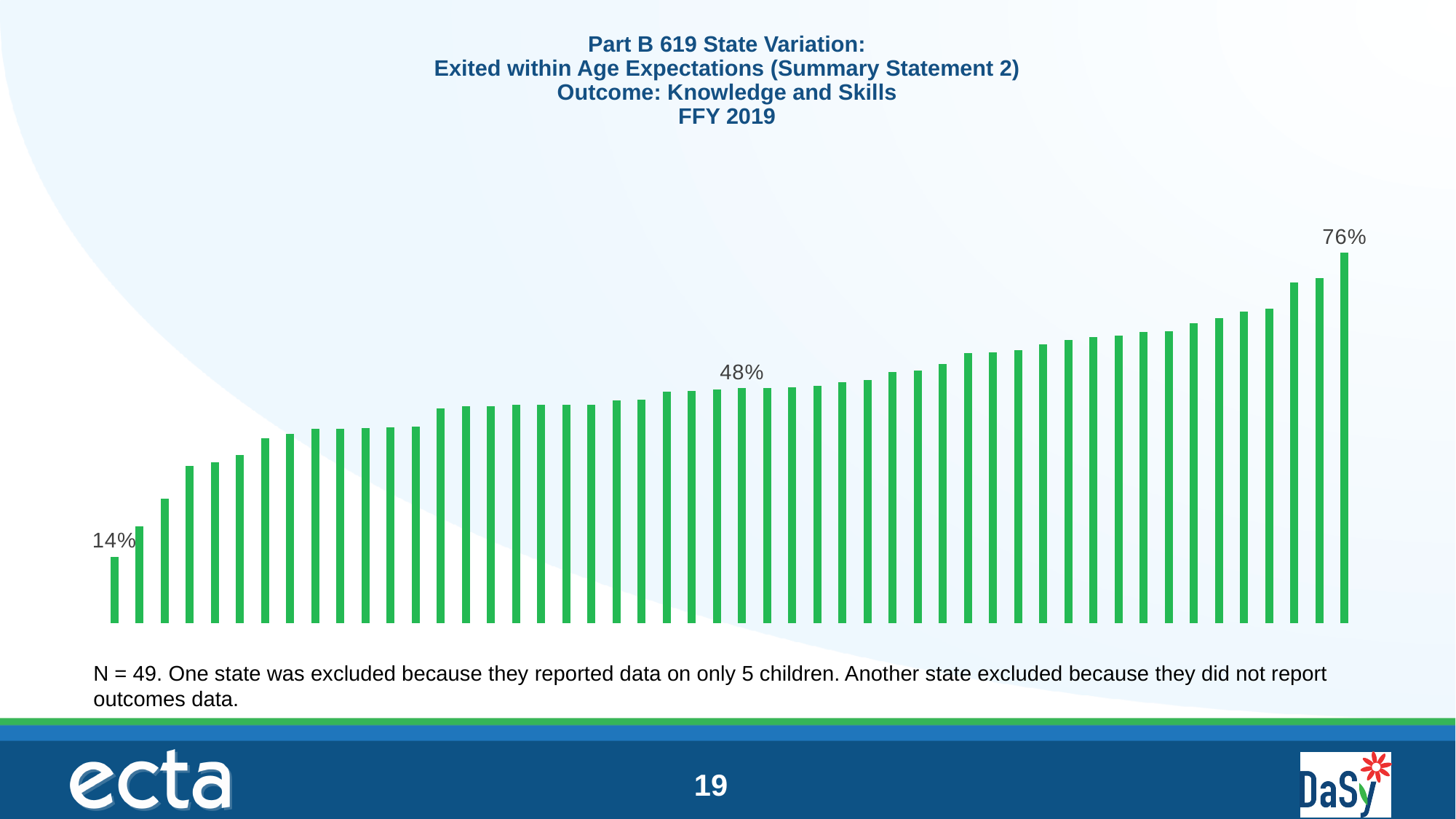
Is the bar labeled 48% larger or smaller than the bar labeled 76%? smaller What kind of chart is shown on the slide? bar chart What is the difference between the highest labeled value (76%) and the lowest labeled value (14%)? 62 percentage points What is the value of the tallest bar in the chart? 76% Which fiscal year does the chart title say the data is for? FFY 2019 Do the bar values rise or fall from left to right across the chart? rise How many bars (states) are plotted in the chart? 50 Which bar is larger, the leftmost bar or the rightmost bar? the rightmost bar What value is printed on the data label near the middle of the chart? 48% What is the value of the shortest bar in the chart? 14% Which outcome does the chart title say the data covers? Knowledge and Skills